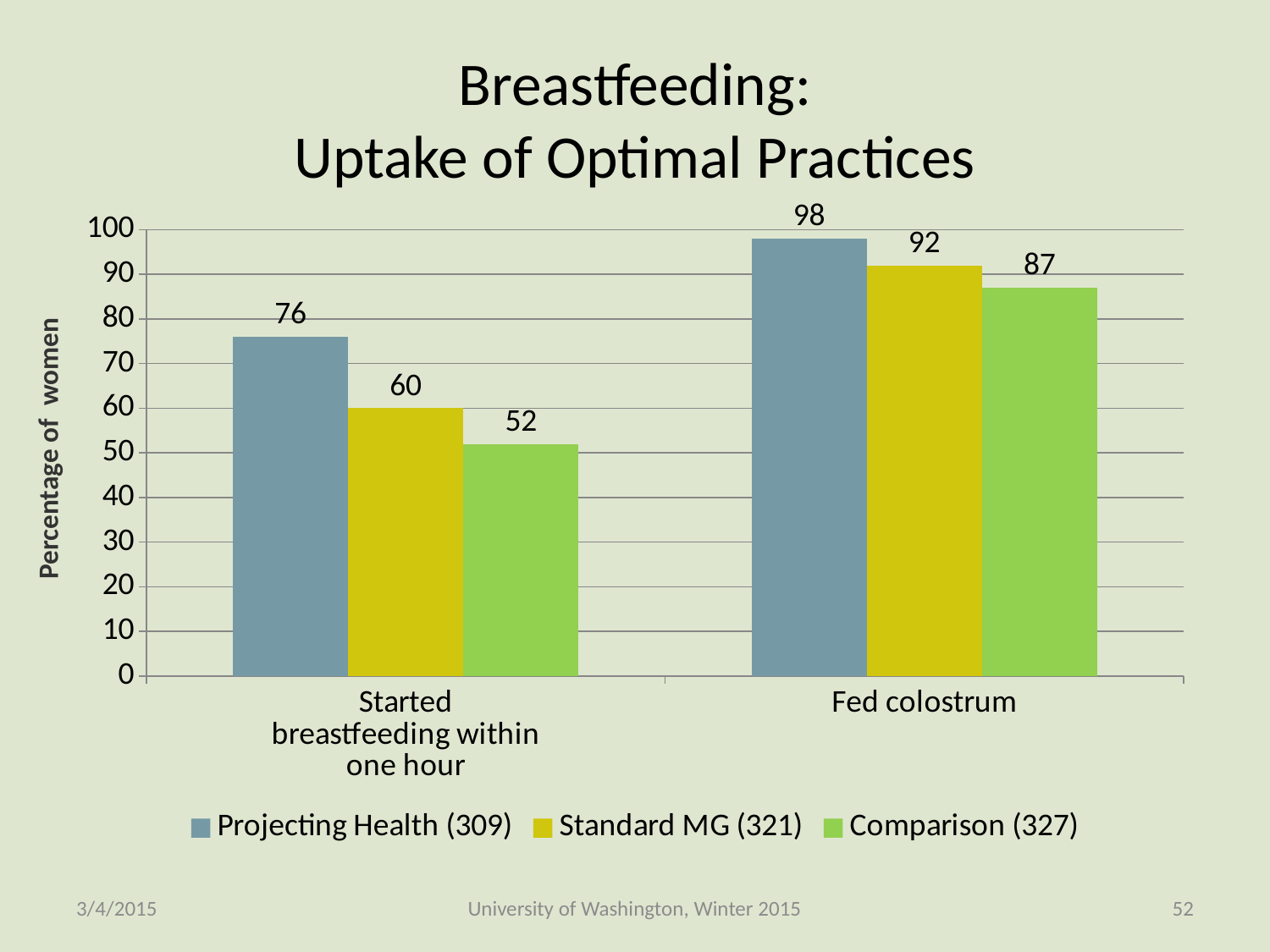
Which series has the highest value for 'Fed colostrum'? Projecting Health (309) Which series has the lowest value for 'Started breastfeeding within one hour'? Comparison (327) What kind of chart is shown on the slide? Bar chart How many series does the legend list? 3 What is the value for Standard MG (321) for 'Started breastfeeding within one hour'? 60 What is the label of the y axis? Percentage of women What is the value for Projecting Health (309) for 'Started breastfeeding within one hour'? 76 Which is larger: the Standard MG (321) value for 'Fed colostrum' or the Comparison (327) value for 'Fed colostrum'? Standard MG (321) for 'Fed colostrum' What is the difference between the Standard MG (321) values for 'Fed colostrum' and 'Started breastfeeding within one hour'? 32 What is the value for Comparison (327) for 'Fed colostrum'? 87 How many categories are shown on the x axis? 2 What is the difference between the Projecting Health (309) and Comparison (327) values for 'Started breastfeeding within one hour'? 24